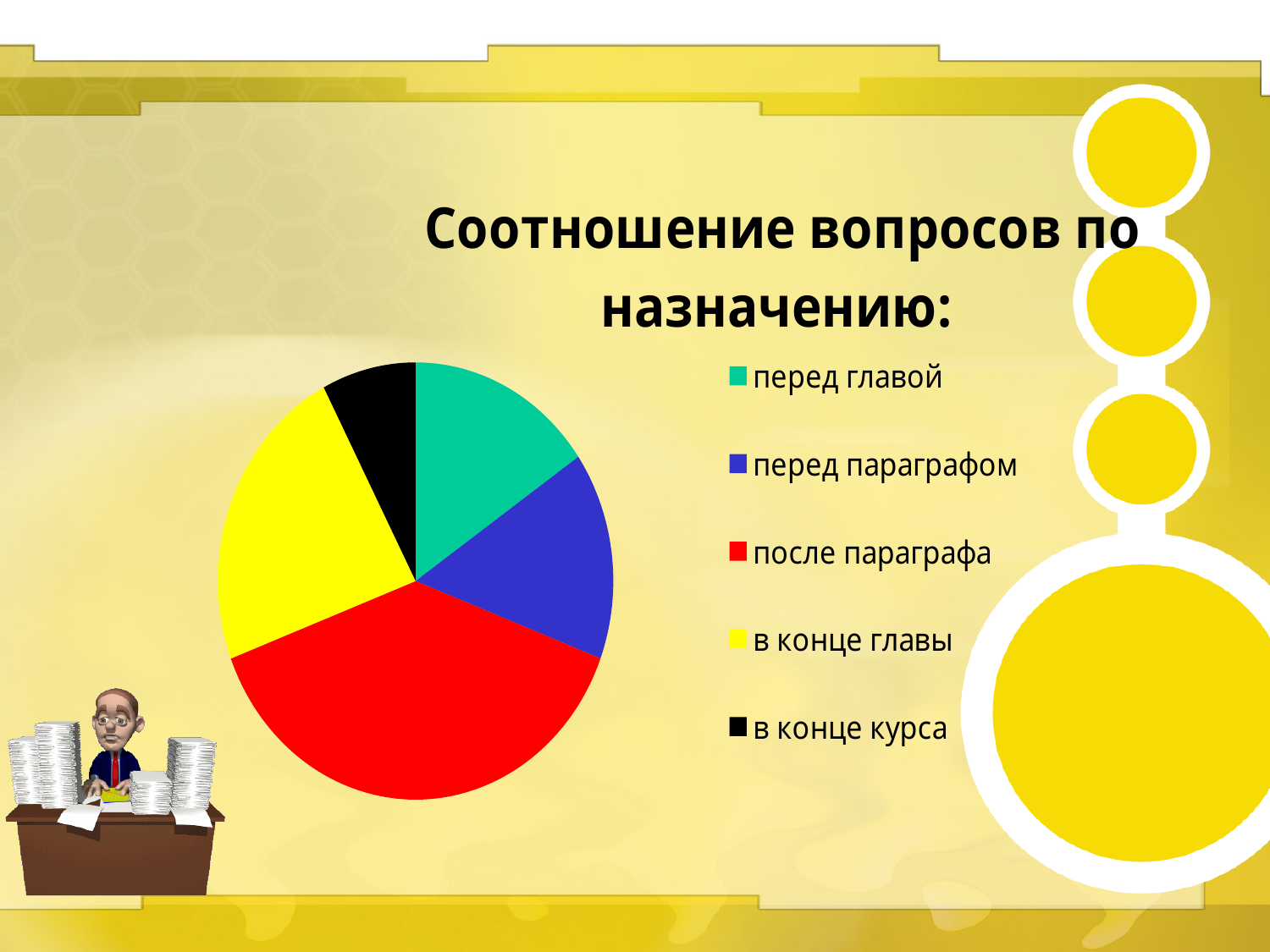
What colour is the slice for "в конце главы" in the pie chart? yellow How many entries does the legend of the pie chart list? 5 Which slice is larger: "в конце главы" or "перед параграфом"? в конце главы How many slices does the pie chart have? 5 Which slice is larger: "после параграфа" or "в конце главы"? после параграфа What kind of chart is shown on the slide? pie chart What is the title of the chart on the slide? Соотношение вопросов по назначению: Which category has the largest slice of the pie chart? после параграфа Which category has the smallest slice of the pie chart? в конце курса Which slice is larger: "после параграфа" or "в конце курса"? после параграфа